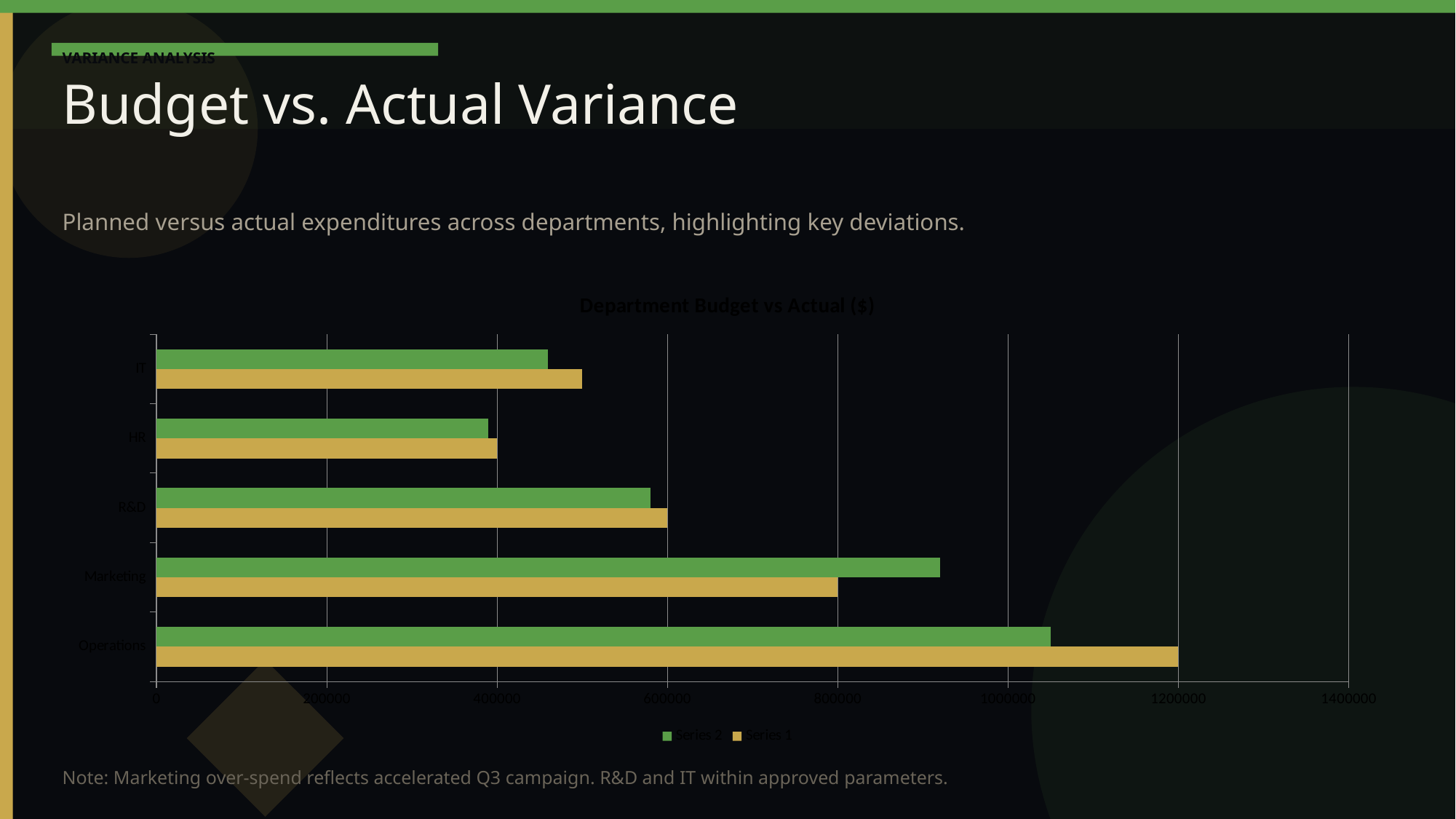
How many series does the legend list? 2 What is the Series 1 value for Operations? 1200000 What is the Series 1 value for Marketing? 800000 What is the Series 1 value for HR? 400000 Which department has the lowest Series 1 value? HR Is the Series 2 value for IT greater or less than 600000? less What is the title of the chart? Department Budget vs Actual ($) Is the Series 2 value for Operations greater or less than 1000000? greater For Marketing, which is larger: Series 1 or Series 2? Series 2 Which department has the highest Series 2 value? Operations How many departments are shown on the chart? 5 What kind of chart is shown on the slide? Bar chart